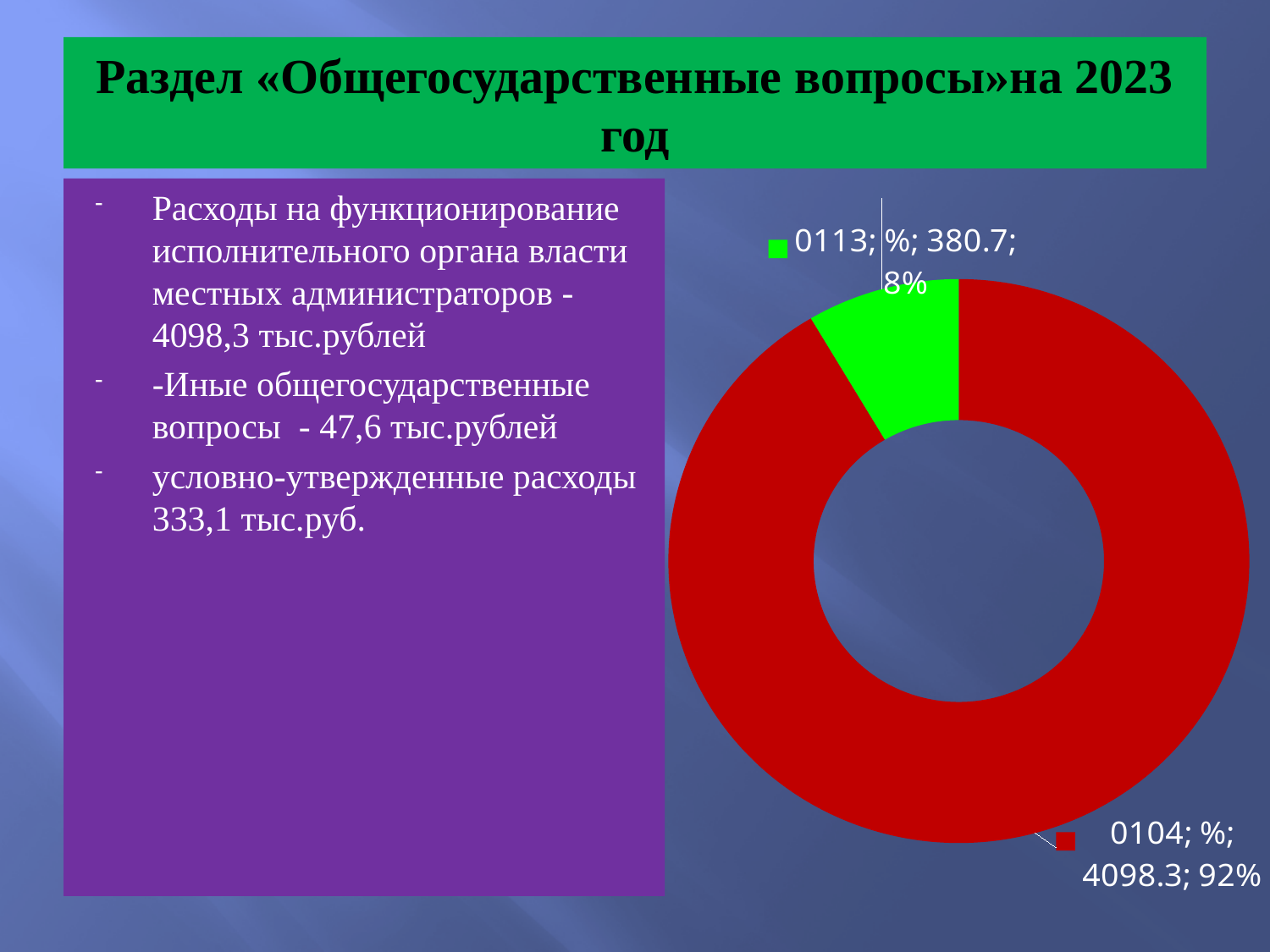
What is the value shown for category 0104? 4098.3 Which is larger, the value for 0104 or the value for 0113? 0104 What kind of chart is shown on the slide? doughnut chart What is the difference between the values for 0104 and 0113? 3717.6 What is the value shown for category 0113? 380.7 What colour is the slice for category 0113? green What share of the chart does category 0104 represent? 92% What share of the chart does category 0113 represent? 8% Which category has the largest slice? 0104 What colour is the slice for category 0104? red How many slices does the chart have? 2 Which category has the smallest slice? 0113